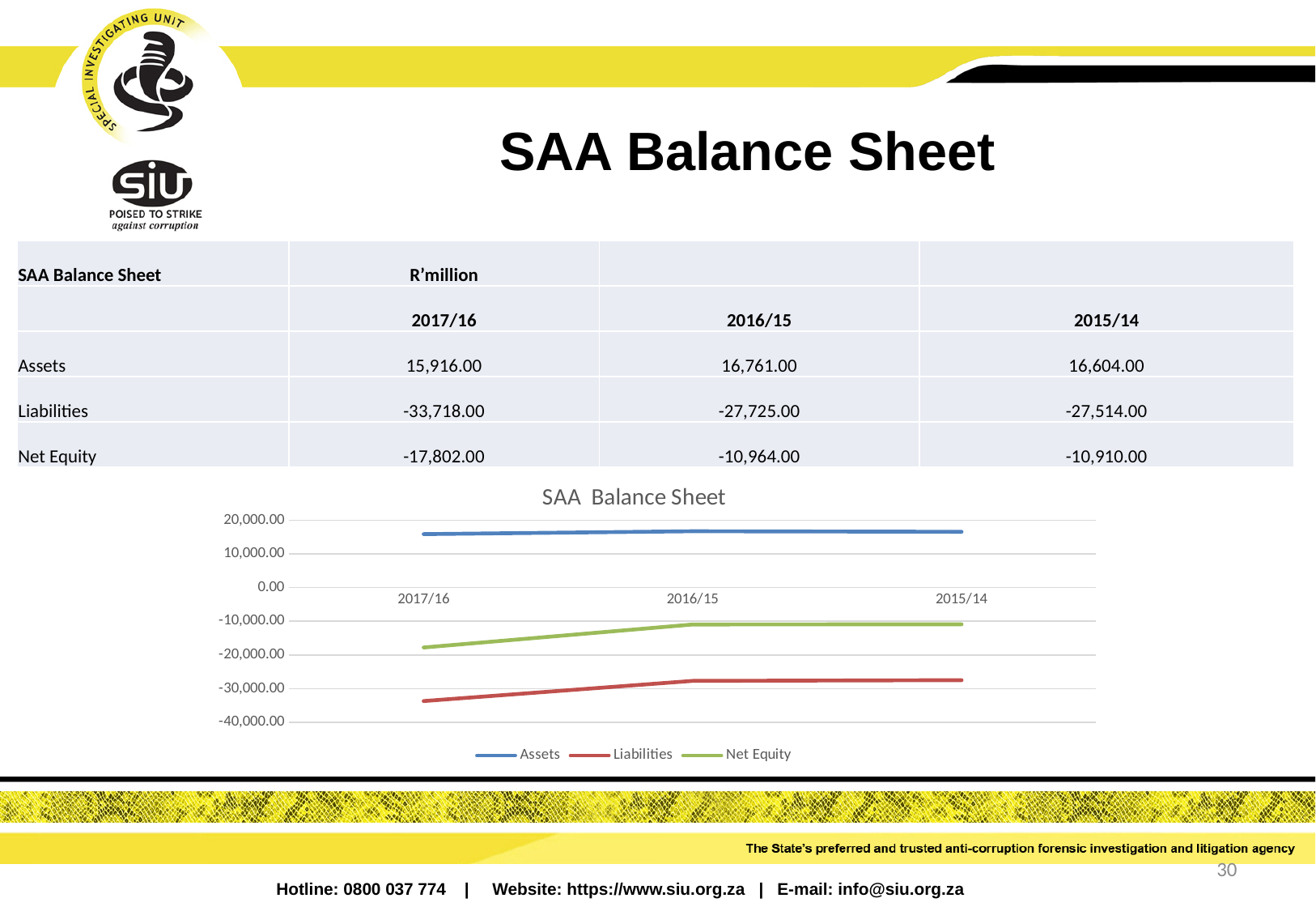
In which period is Assets highest? 2016/15 What is the title of the chart? SAA Balance Sheet How many periods are plotted along the x axis of the chart? 3 How many series does the chart legend list? 3 In which period is Net Equity lowest? 2017/16 What is the value of Liabilities for 2016/15? -27,725.00 What is the value of Assets for 2017/16? 15,916.00 What is the value of Net Equity for 2015/14? -10,910.00 What type of chart is shown on the slide? line chart Is the value for Liabilities in 2017/16 greater or less than -30,000.00? less What is the difference between Assets in 2016/15 and Assets in 2017/16? 845.00 Which is larger, Net Equity in 2016/15 or Net Equity in 2015/14? 2015/14